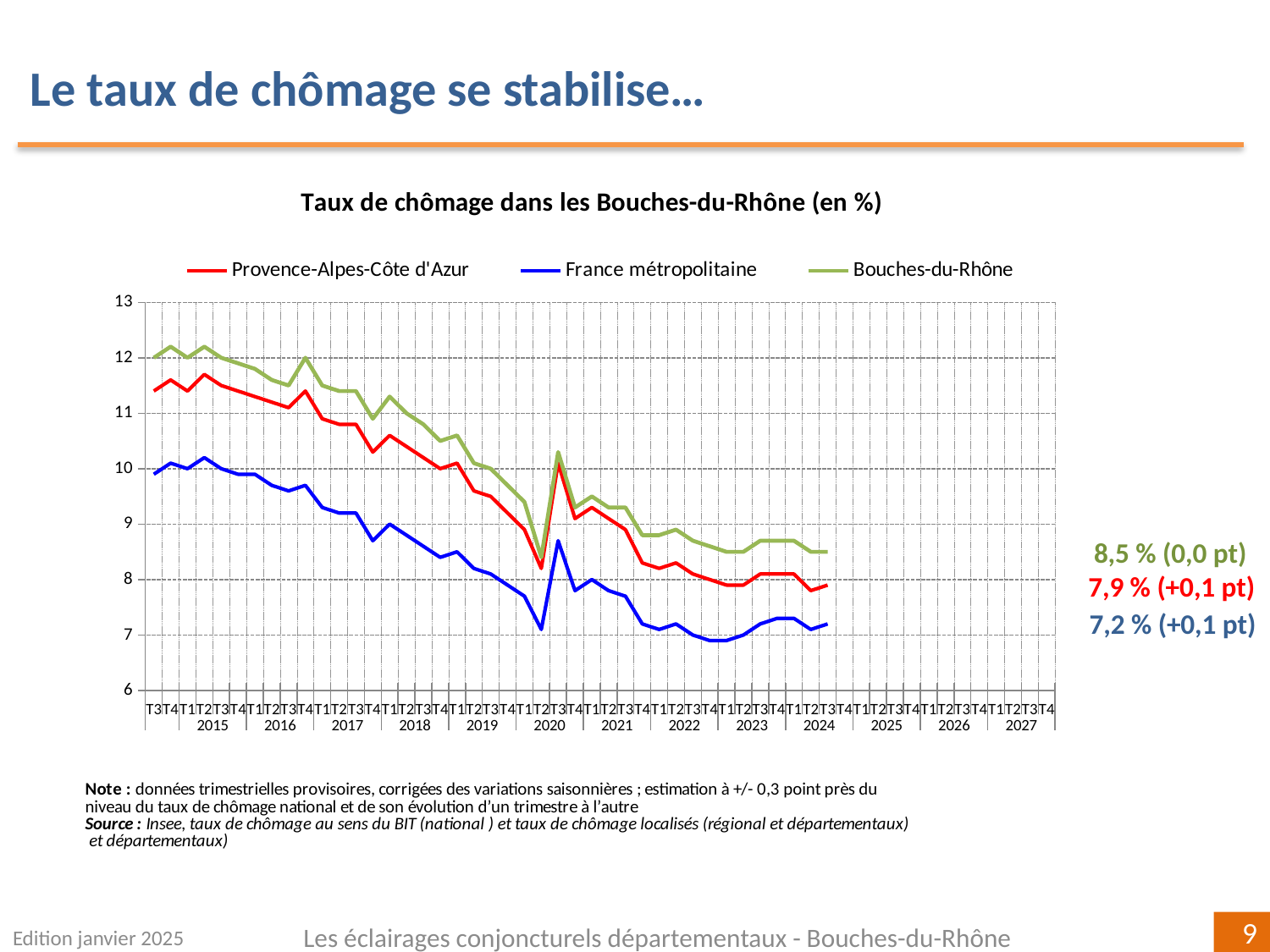
Which series has the highest values across the whole period shown? Bouches-du-Rhône Which series has the lowest values across the whole period shown? France métropolitaine What is the latest unemployment rate shown for Provence-Alpes-Côte d'Azur? 7,9 % What kind of chart is shown on the slide? line chart What is the difference between the latest rates for Bouches-du-Rhône (8,5 %) and France métropolitaine (7,2 %)? 1,3 points Which series is drawn in green in the chart? Bouches-du-Rhône What is the latest unemployment rate shown for Bouches-du-Rhône? 8,5 % Is the value for France métropolitaine at the start of the series in 2015 greater or less than 11? less How many series does the legend list? 3 What is the latest unemployment rate shown for France métropolitaine? 7,2 % Overall, do the unemployment rates rise or fall between 2015 and 2024? fall What is the title of the chart? Taux de chômage dans les Bouches-du-Rhône (en %)